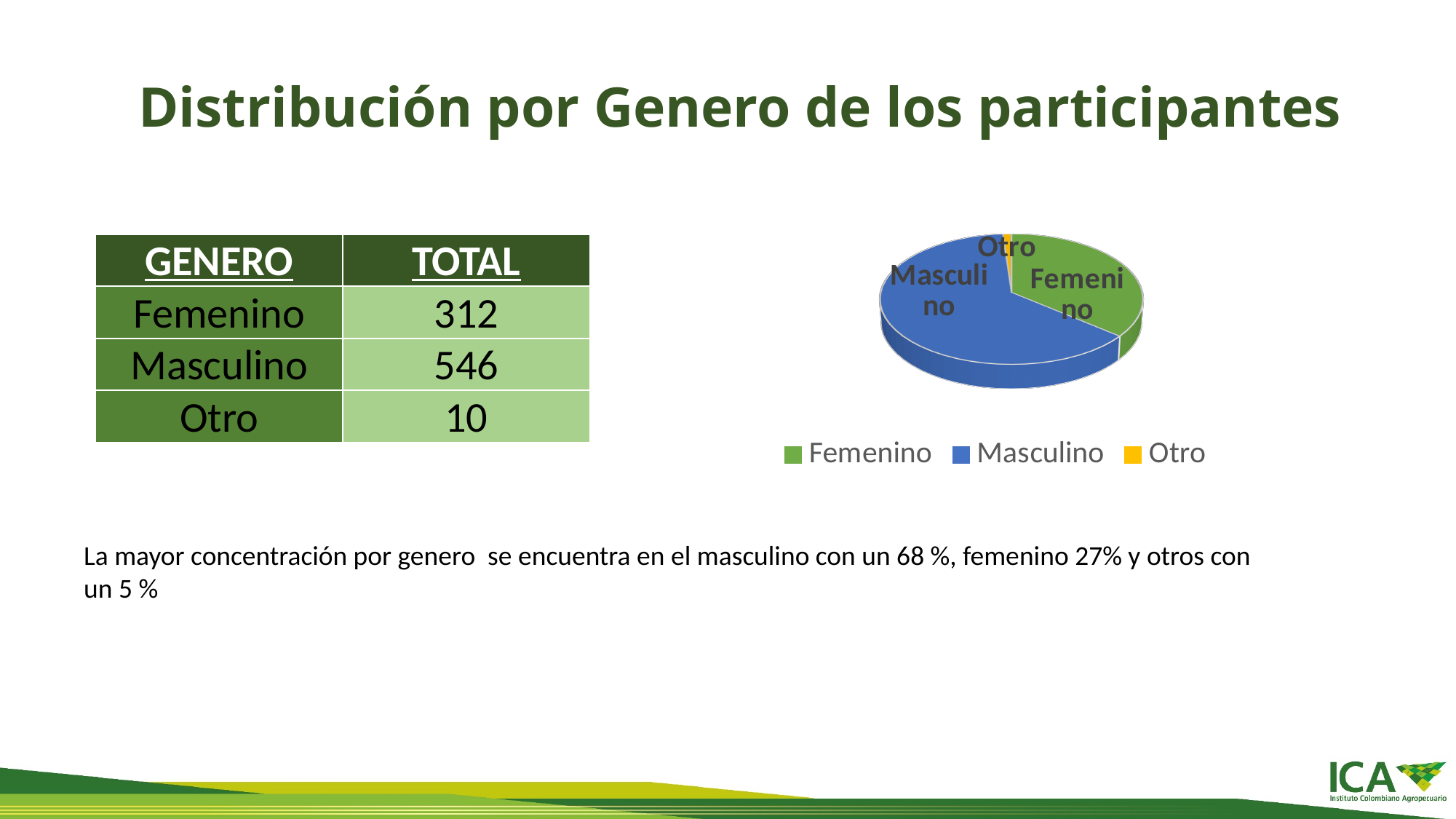
What is the difference between the Masculino and Femenino totals shown on the slide? 234 What colour is the Masculino slice in the pie chart? blue Which slice is larger in the pie chart, Femenino or Masculino? Masculino Which category has the smallest slice in the pie chart? Otro How many entries does the pie chart's legend list? 3 What is the total for Otro shown on the slide? 10 What is the total for Femenino shown on the slide? 312 How many slices does the pie chart have? 3 Which slice is larger in the pie chart, Otro or Femenino? Femenino Which category has the largest slice in the pie chart? Masculino What kind of chart is shown on the slide? pie chart What is the total for Masculino shown on the slide? 546